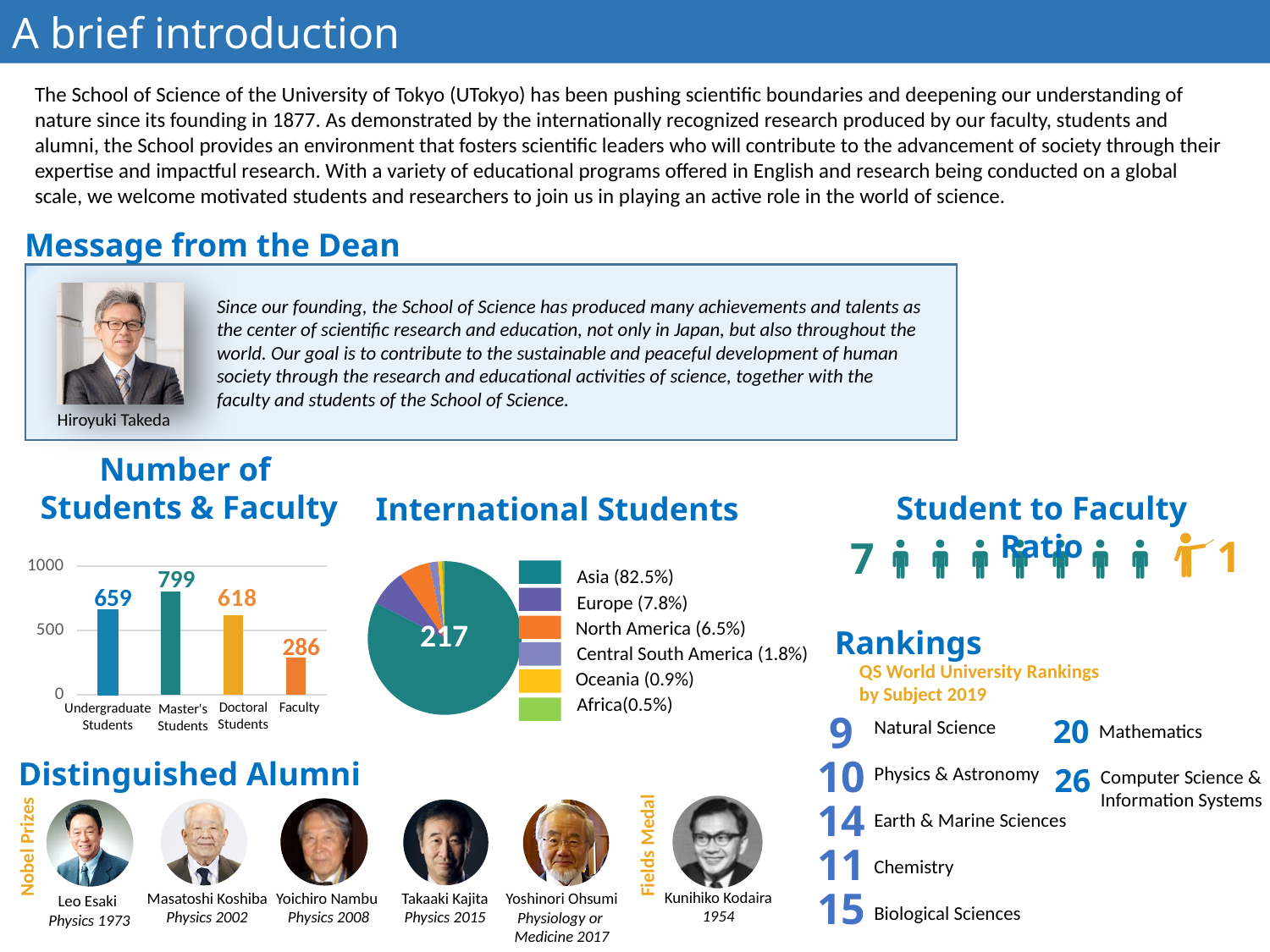
In the Number of Students & Faculty chart, which category has the lowest value? Faculty In the Number of Students & Faculty chart, what is the value for Faculty? 286 In the Number of Students & Faculty chart, what is the difference between Undergraduate Students and Doctoral Students? 41 In the International Students chart, which region has the smallest share? Africa In the Number of Students & Faculty chart, which category has the highest value? Master's Students In the Number of Students & Faculty chart, what is the value for Master's Students? 799 In the International Students chart, which region has the largest share? Asia In the Number of Students & Faculty chart, which is larger, Undergraduate Students or Doctoral Students? Undergraduate Students What kind of chart is the International Students chart? Pie chart In the Number of Students & Faculty chart, how many categories are shown? 4 In the International Students chart, what share of the pie is Europe? 7.8% What kind of chart is the Number of Students & Faculty chart? Bar chart